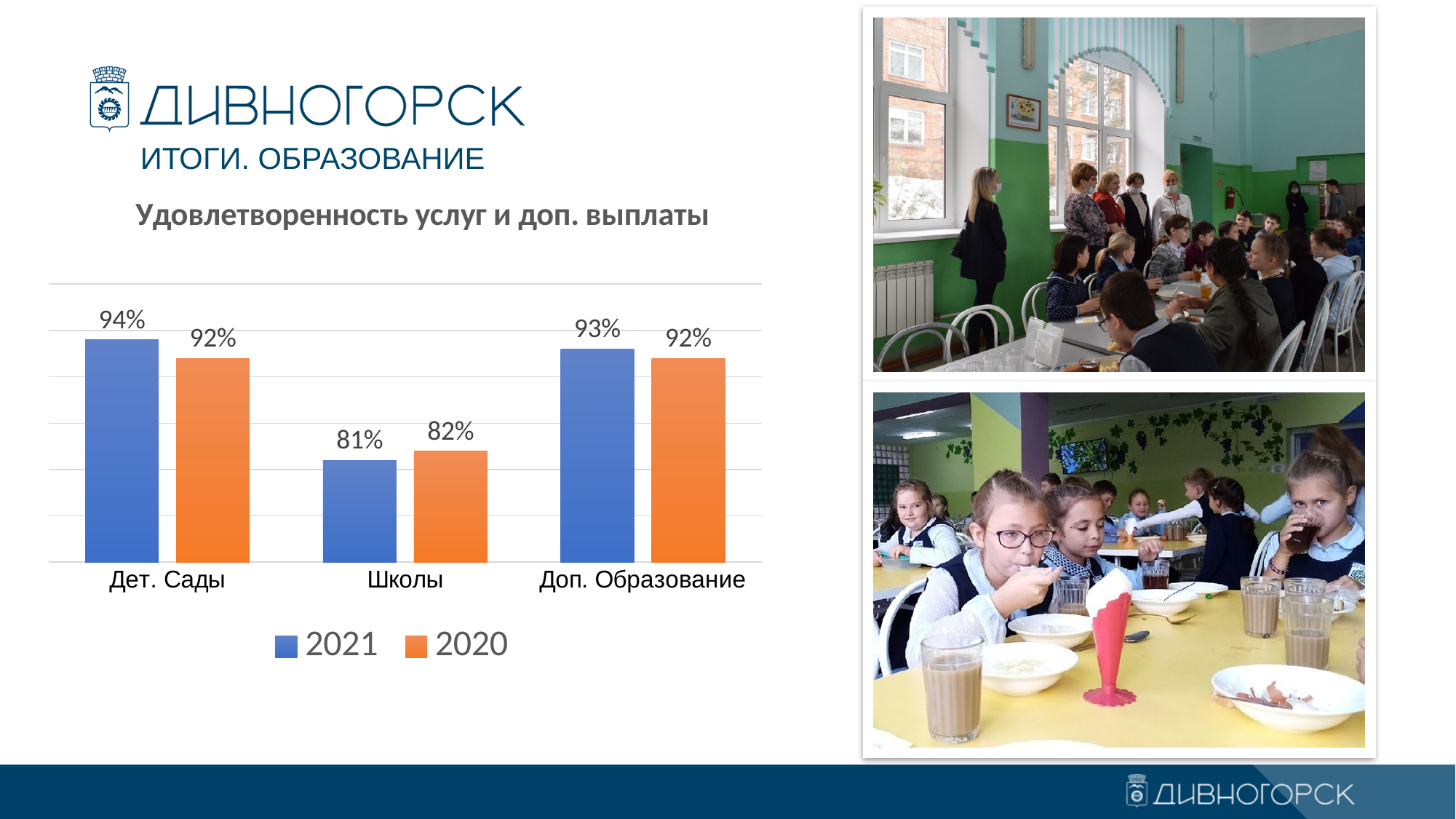
What is the difference between the 2021 and 2020 values for Дет. Сады? 2% What is the 2020 value for Школы? 82% What is the title of the chart? Удовлетворенность услуг и доп. выплаты Which category has the lowest 2020 value? Школы How many categories are shown on the x axis? 3 What is the 2021 value for Дет. Сады? 94% What is the 2021 value for Доп. Образование? 93% What is the 2020 value for Дет. Сады? 92% For Школы, which year has the larger value, 2021 or 2020? 2020 Which category has the highest 2021 value? Дет. Сады How many series does the legend list? 2 What kind of chart is shown on the slide? Bar chart